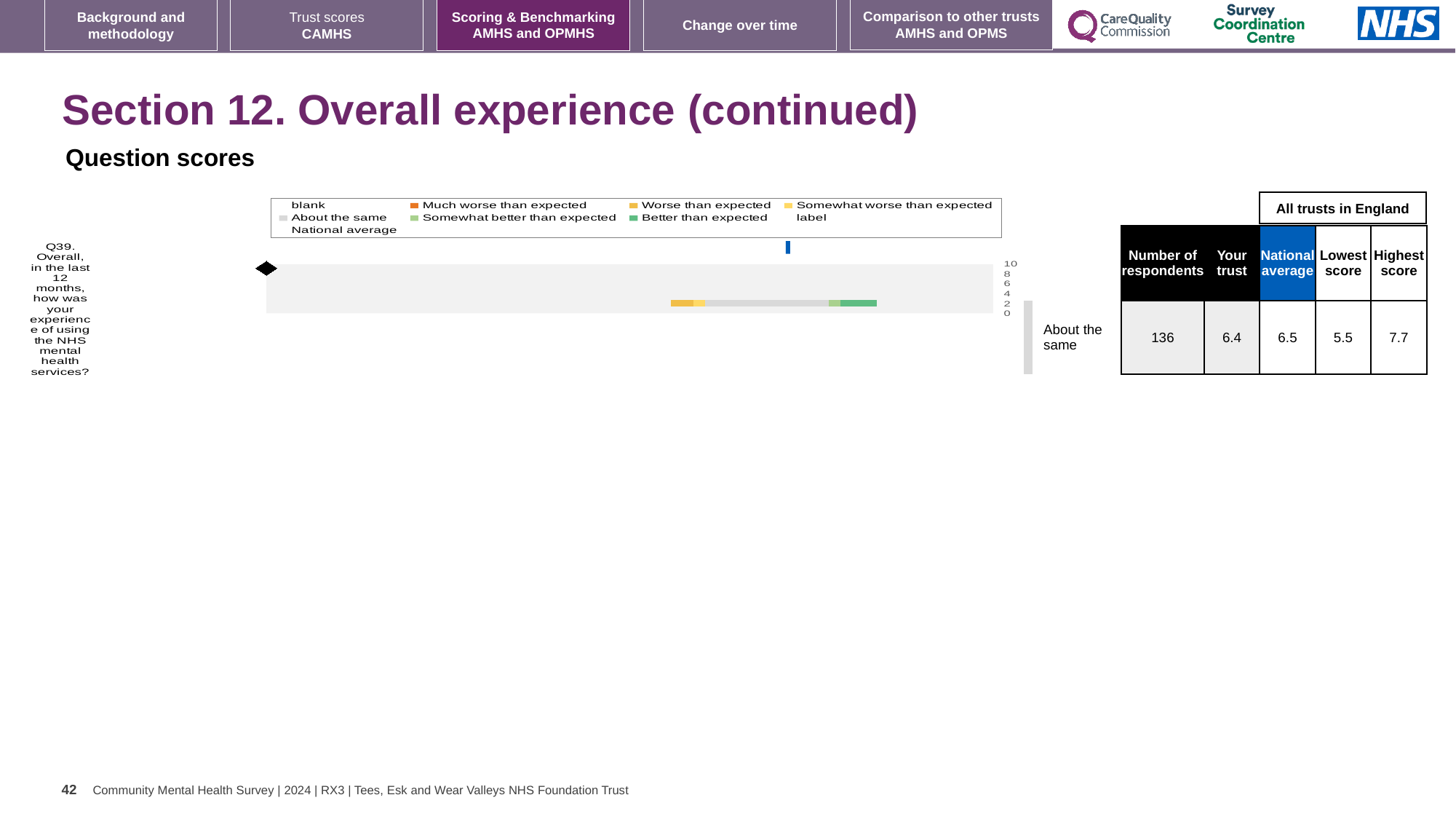
What is the lowest score among all trusts in England for Q39? 5.5 For Q39, which is larger: the 'Your trust' score or the national average? National average Which benchmark category label is shown to the right of the Q39 bar? About the same What is the difference between the national average and the 'Your trust' score for Q39? 0.1 How many survey questions are plotted in the question scores chart? 1 Which question number is plotted in the question scores chart? Q39 How many respondents answered Q39 according to the table next to the chart? 136 What is the difference between the highest score and the lowest score for Q39? 2.2 What is the highest score among all trusts in England for Q39? 7.7 What kind of chart is shown on the slide for the question scores? bar chart What is the 'Your trust' score for Q39 shown in the table next to the chart? 6.4 What is the national average score for Q39 shown in the table next to the chart? 6.5